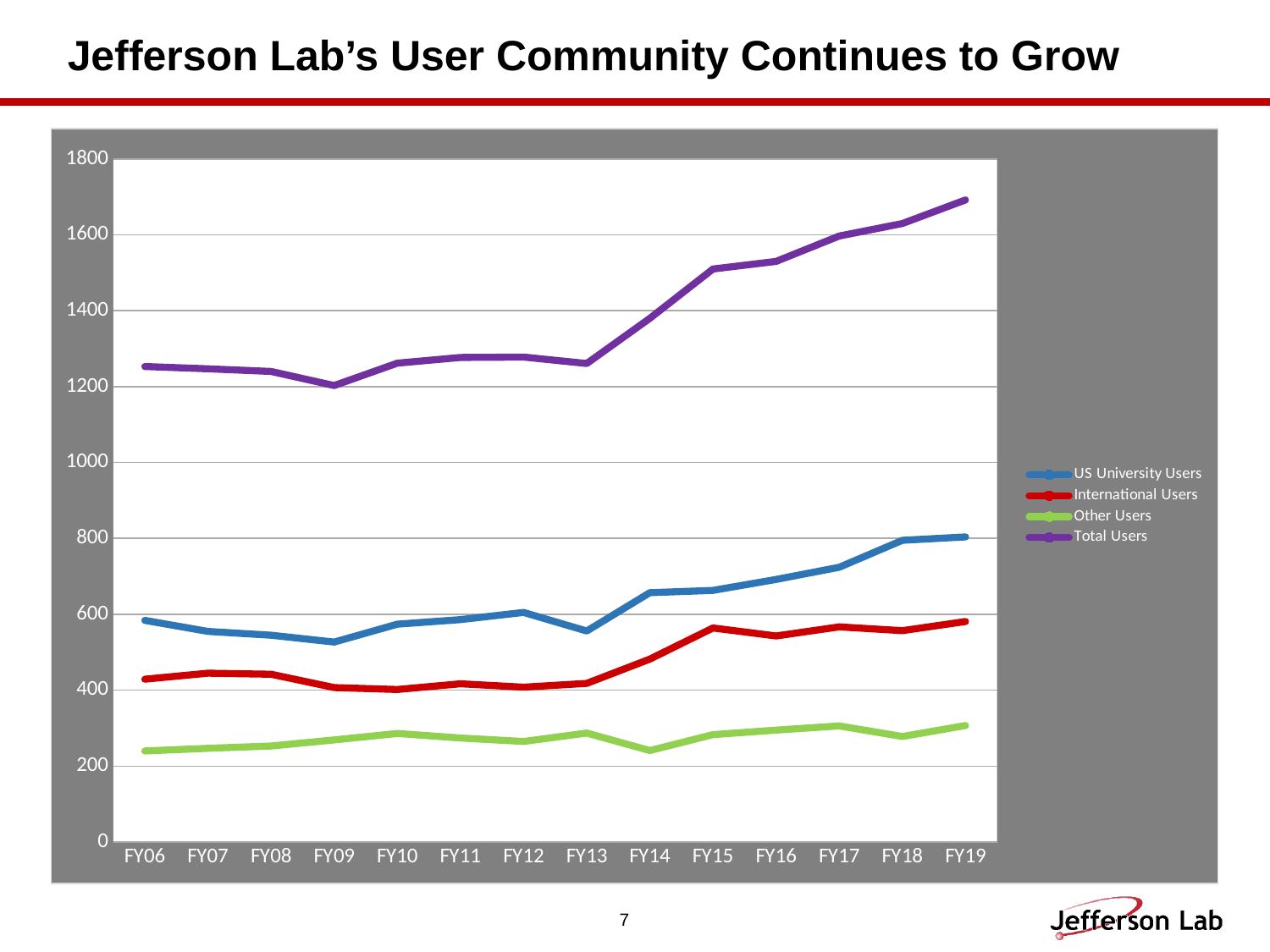
In which fiscal year is the Total Users line at its highest? FY19 In FY06, which is larger: US University Users or International Users? US University Users How many series does the legend list? 4 Is the value for Other Users in FY14 greater or less than 200? greater Is the value for US University Users in FY09 greater or less than 600? less Does the Total Users line rise or fall overall from FY06 to FY19? rise Which series is drawn in purple? Total Users How many fiscal years are plotted along the x axis? 14 What kind of chart is shown on the slide? line chart In which fiscal year is the Total Users line at its lowest? FY09 Is the value for Total Users in FY19 greater or less than 1600? greater